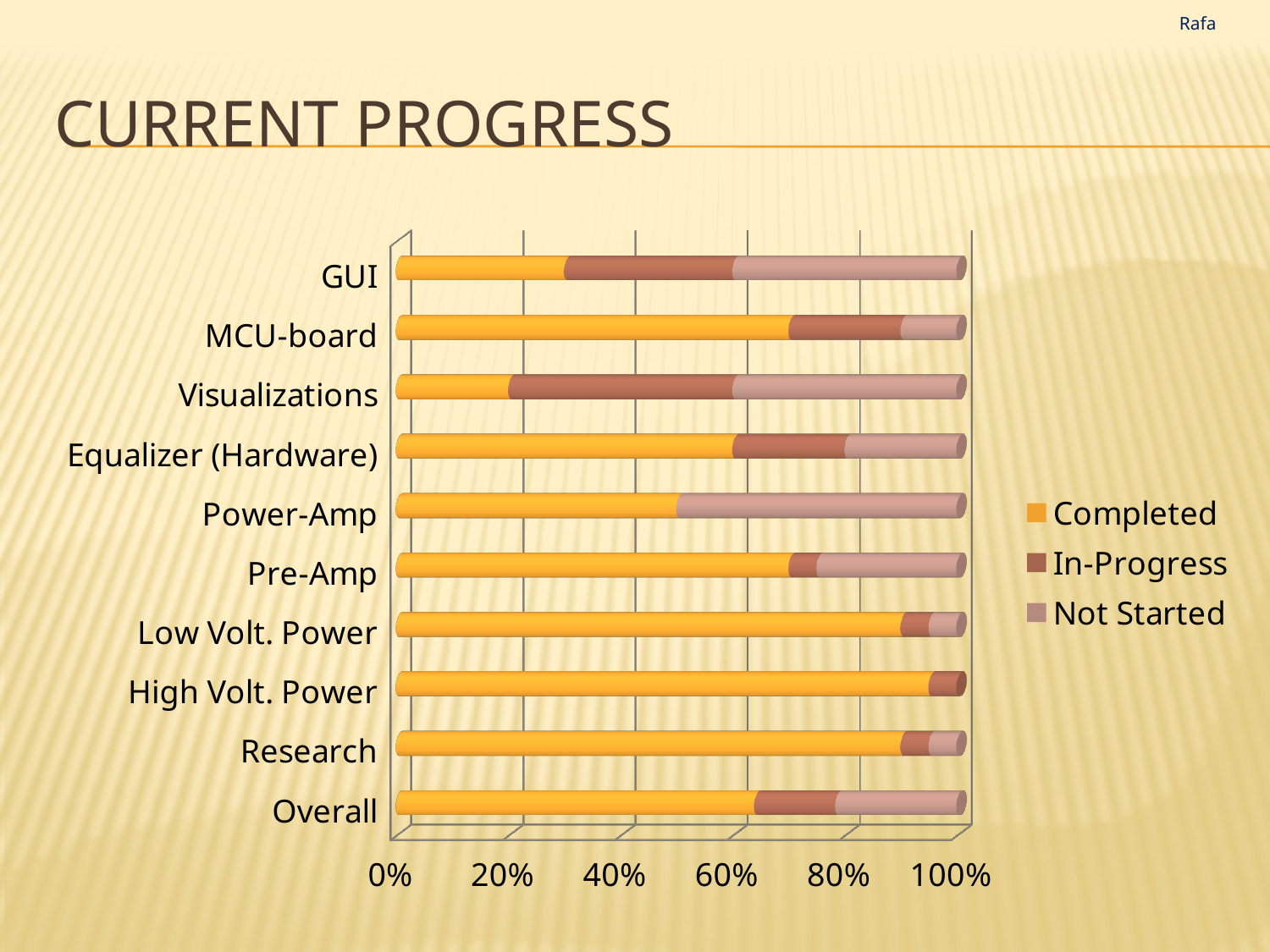
Is the Completed value for MCU-board greater or less than 60%? greater What kind of chart is shown on the slide? Stacked bar chart Which has a larger Completed share, GUI or MCU-board? MCU-board How many categories are plotted on the chart? 10 Is the Completed value for GUI greater or less than 40%? less How many series does the legend list? 3 Is the Completed value for Power-Amp greater or less than 60%? less What is the title of the chart slide? CURRENT PROGRESS Which category has the largest In-Progress segment? Visualizations Which category has the highest Completed share? High Volt. Power Which series is shown in the darkest brown colour in the legend? In-Progress Which category has the lowest Completed share? Visualizations